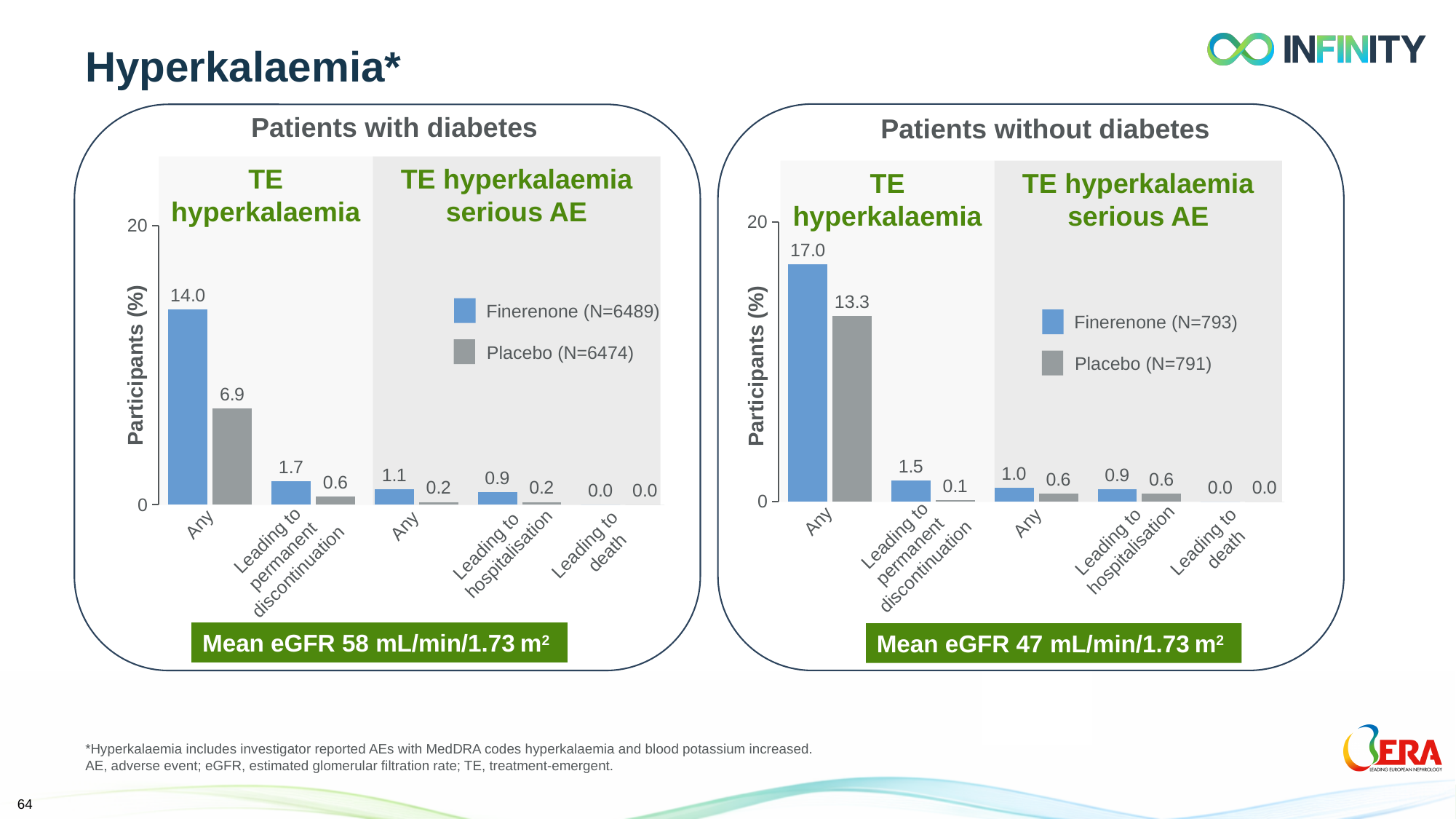
In the 'Patients with diabetes' chart, which category has the highest Finerenone value? Any (TE hyperkalaemia) What kind of chart is shown for 'Patients with diabetes'? Bar chart In the 'Patients without diabetes' chart, what is the Placebo value for 'Leading to hospitalisation'? 0.6 In the 'Patients without diabetes' chart, what is the Placebo value for 'Any' TE hyperkalaemia? 13.3 In the 'Patients without diabetes' chart, what is the difference between the Finerenone and Placebo values for 'Any' TE hyperkalaemia? 3.7 In the 'Patients without diabetes' chart, what is the Finerenone value for 'Leading to death'? 0.0 In the 'Patients with diabetes' chart, what is the difference between the Finerenone and Placebo values for 'Any' TE hyperkalaemia? 7.1 In the 'Patients with diabetes' chart, what is the Finerenone value for 'Any' TE hyperkalaemia? 14.0 How many series does the legend list in the 'Patients without diabetes' chart? 2 In the 'Patients with diabetes' chart, what is the Finerenone value for 'Leading to permanent discontinuation'? 1.7 In the 'Patients with diabetes' chart, what N is given for Placebo in the legend? N=6474 In the 'Patients with diabetes' chart, which is larger for 'Any' TE hyperkalaemia serious AE: Finerenone or Placebo? Finerenone